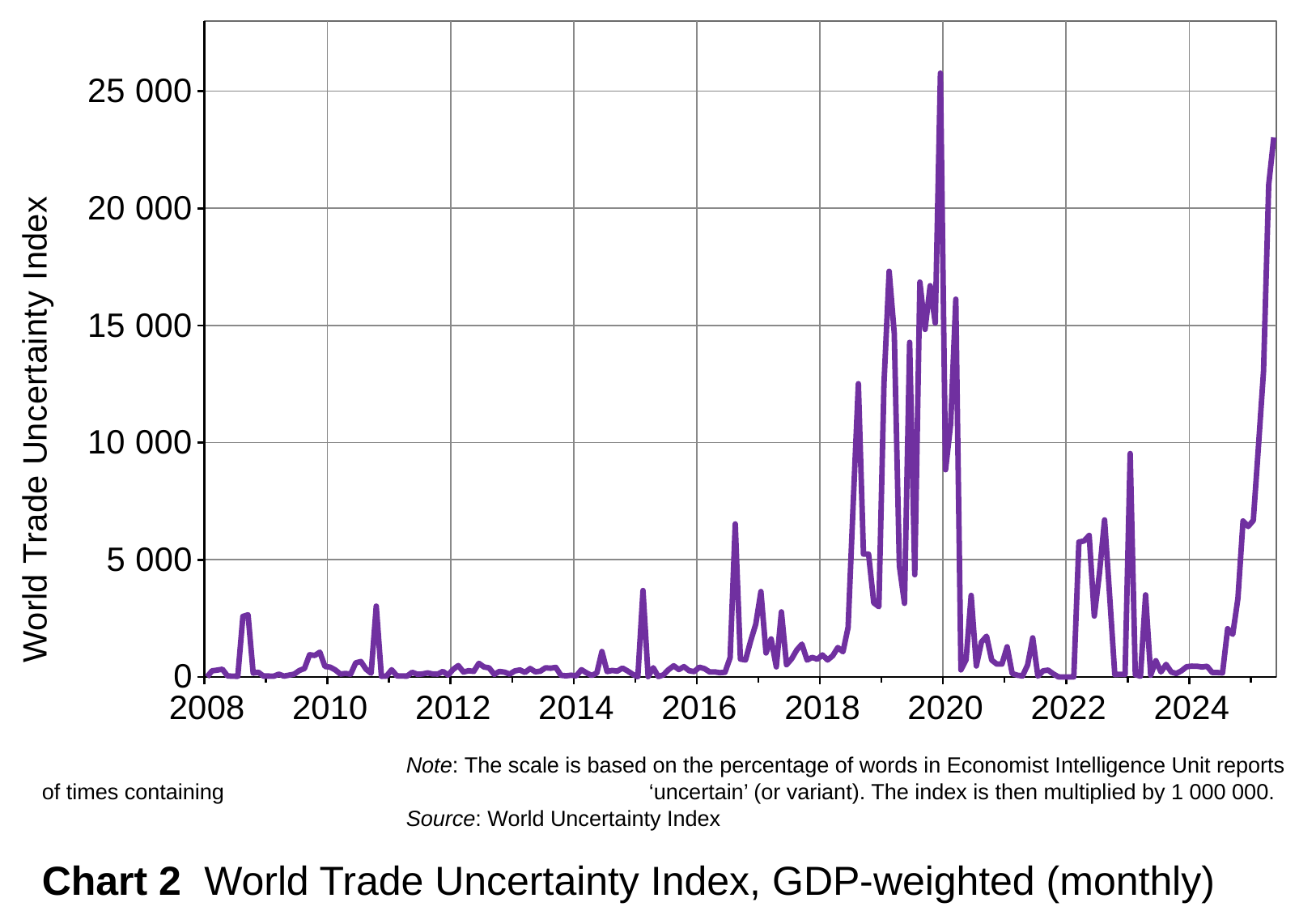
Is the highest peak of the index, around 2020, greater or less than 20 000? greater What is the label on the vertical axis of the chart? World Trade Uncertainty Index Is the value of the index at the end of the series (2025) greater or less than 25 000? less How many data series are plotted on the chart? 1 Is the peak of the index in 2016 greater or less than 5 000? greater Around which year does the World Trade Uncertainty Index reach its highest value? 2020 What is the title of the chart? Chart 2 World Trade Uncertainty Index, GDP-weighted (monthly) What kind of chart is shown on the slide? line chart Does the index rise or fall from 2024 to the end of the series? rise